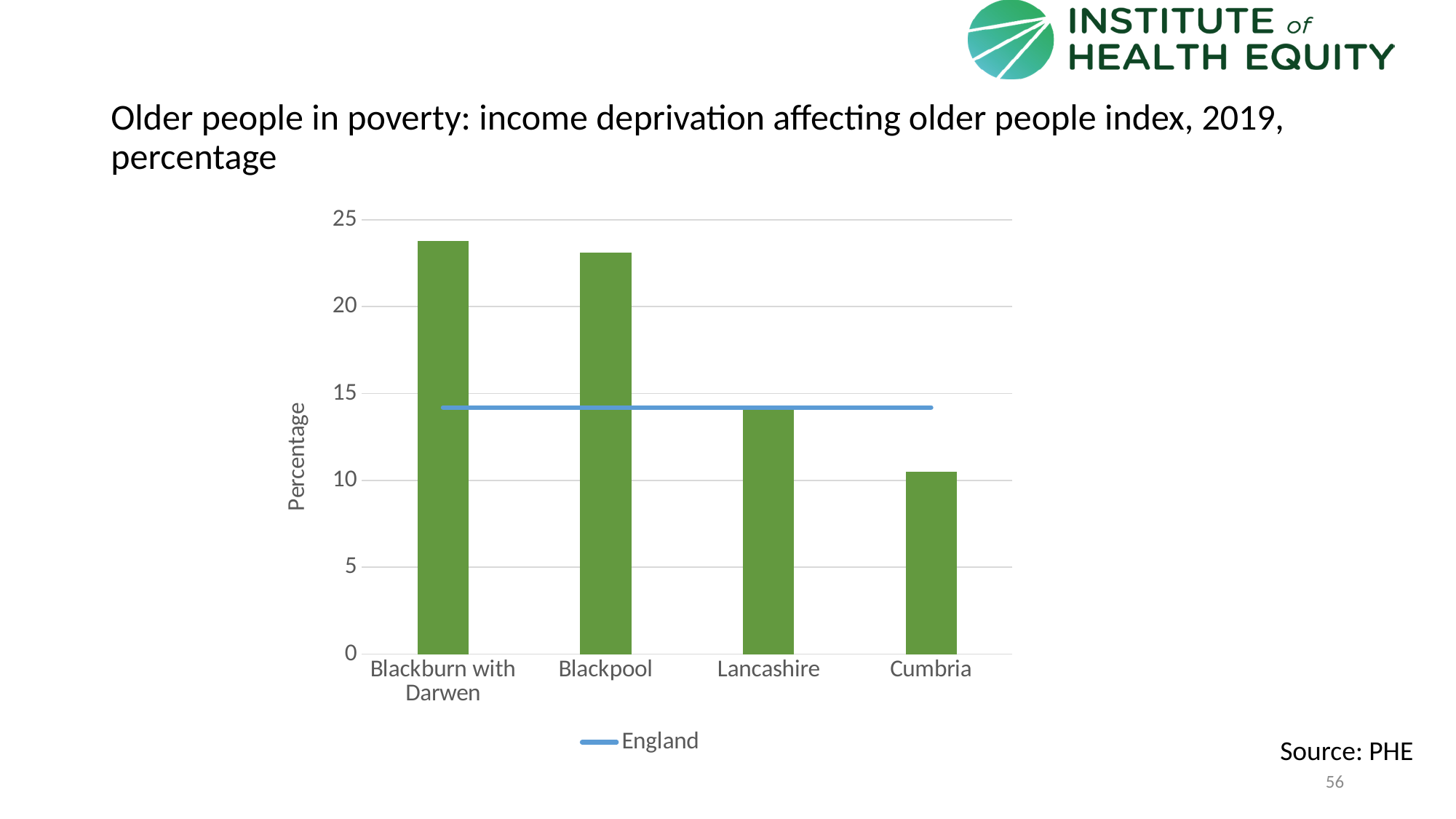
Do the bar values rise or fall from left to right across the chart? fall What kind of chart is shown on the slide? bar chart Is the value for Cumbria greater or less than 15? less Which has a higher percentage, Lancashire or Cumbria? Lancashire Is the value for Blackburn with Darwen greater or less than 20? greater Which has a higher percentage, Blackpool or Lancashire? Blackpool How many areas are shown on the x axis of the chart? 4 Is the value for Lancashire greater or less than 15? less Which area has the highest percentage of older people in poverty? Blackburn with Darwen Which area has the lowest percentage of older people in poverty? Cumbria What does the legend entry for the horizontal blue line represent? England